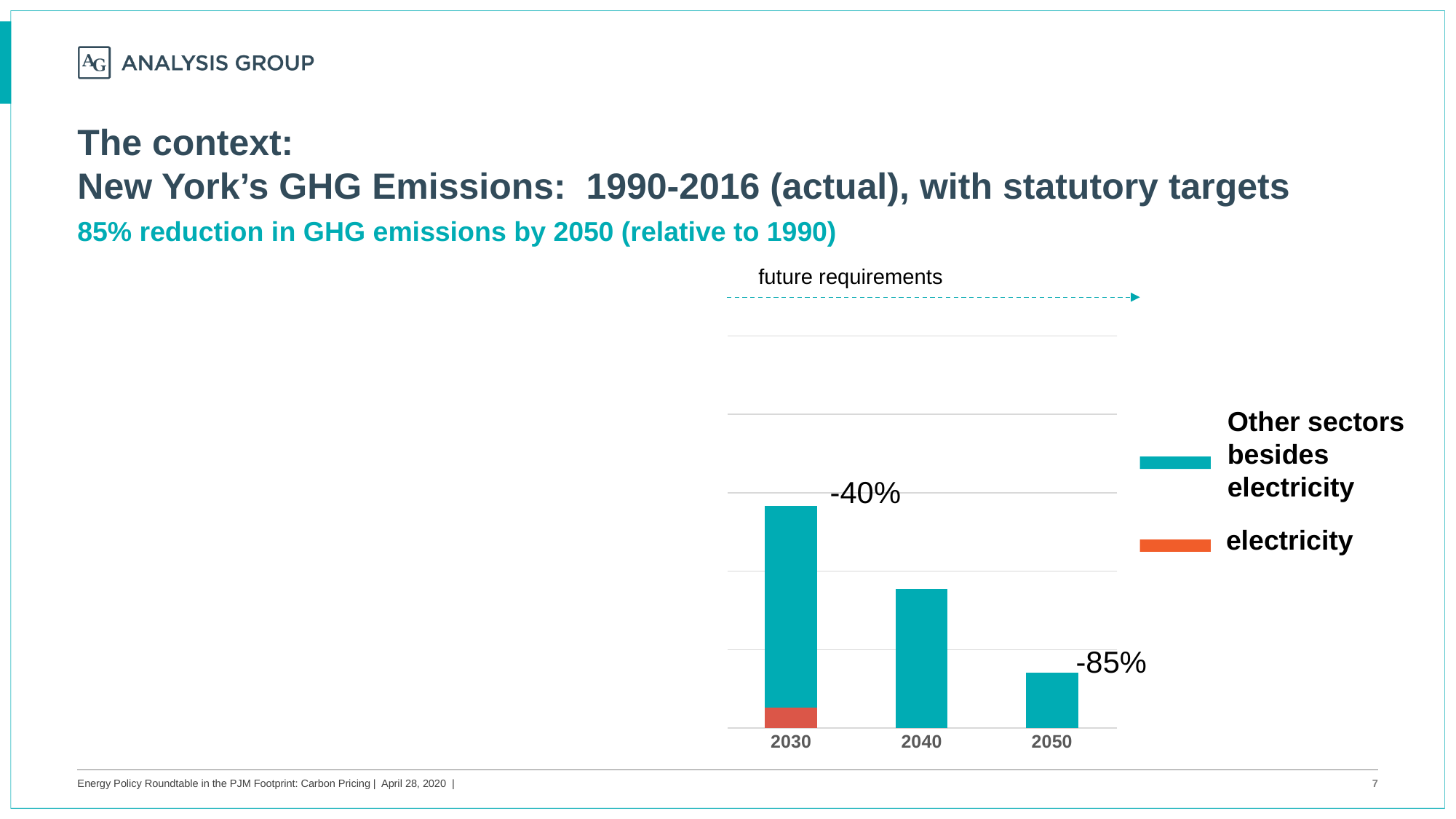
Which series is shown in orange in the chart's legend? electricity Is the bar for 2040 or the bar for 2050 taller? 2040 How many years are shown on the x axis of the chart? 3 How many series does the chart's legend list? 2 What text appears above the dashed arrow at the top of the chart? future requirements Do the bar heights rise or fall from 2030 to 2050? fall Which year has the shortest bar in the chart? 2050 What kind of chart is shown on the slide? bar chart What percentage label is printed next to the 2030 bar? -40% Is the bar for 2030 or the bar for 2040 taller? 2030 Which year has the tallest bar in the chart? 2030 What percentage label is printed next to the 2050 bar? -85%